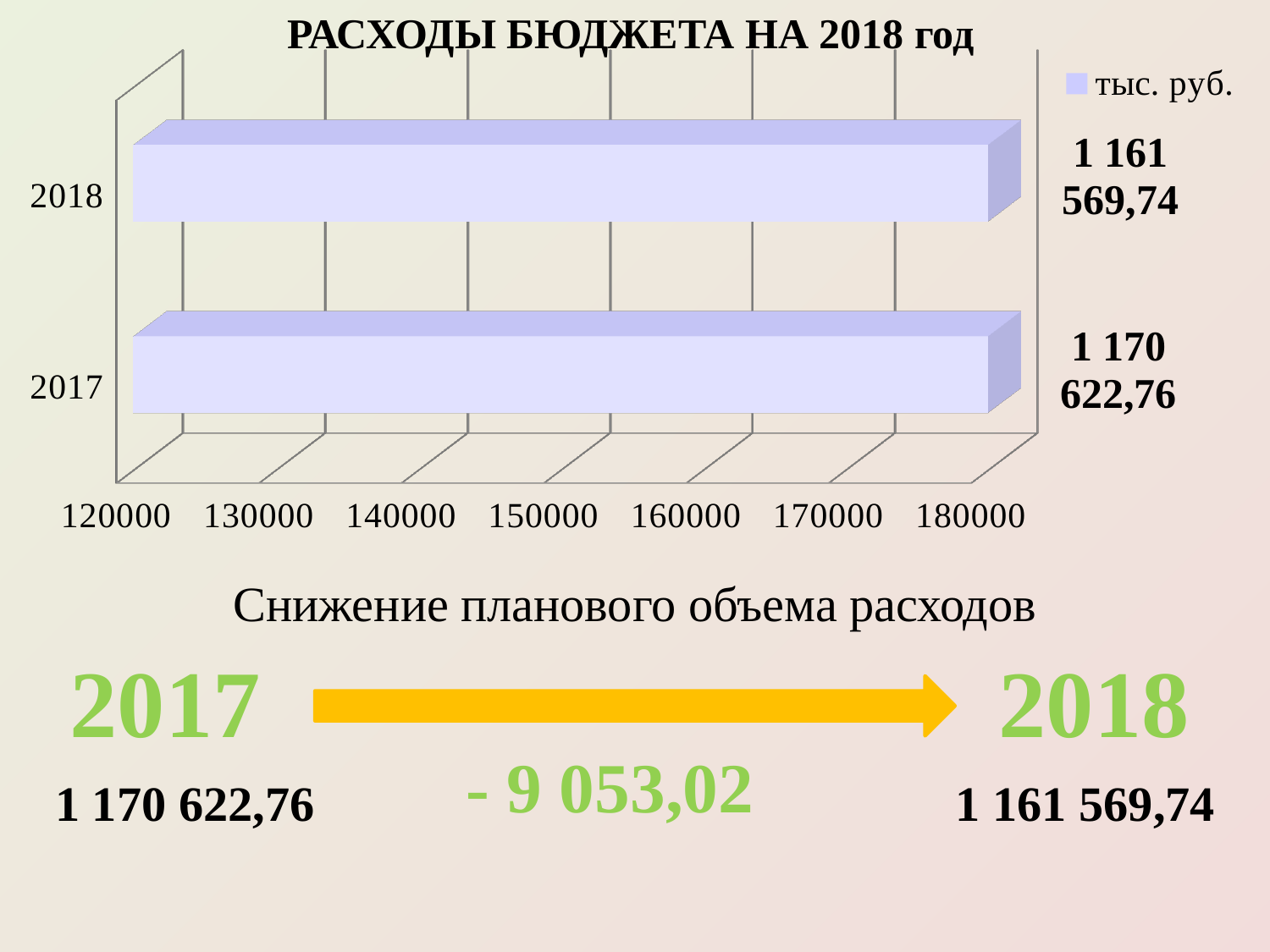
What unit is named in the chart legend? тыс. руб. What kind of chart is shown on the slide? bar chart What is the difference between the 2017 value and the 2018 value? 9 053,02 What is the value for 2017 in the chart? 1 170 622,76 What is the title of the chart? РАСХОДЫ БЮДЖЕТА НА 2018 год Which year has the lower budget expenditure value in the chart? 2018 Is the value for 2017 larger or smaller than the value for 2018? larger How many series does the legend list? 1 How many categories (years) are shown in the chart? 2 Which year has the higher budget expenditure value in the chart? 2017 What is the value for 2018 in the chart? 1 161 569,74 Does the planned expenditure rise or fall from 2017 to 2018? fall